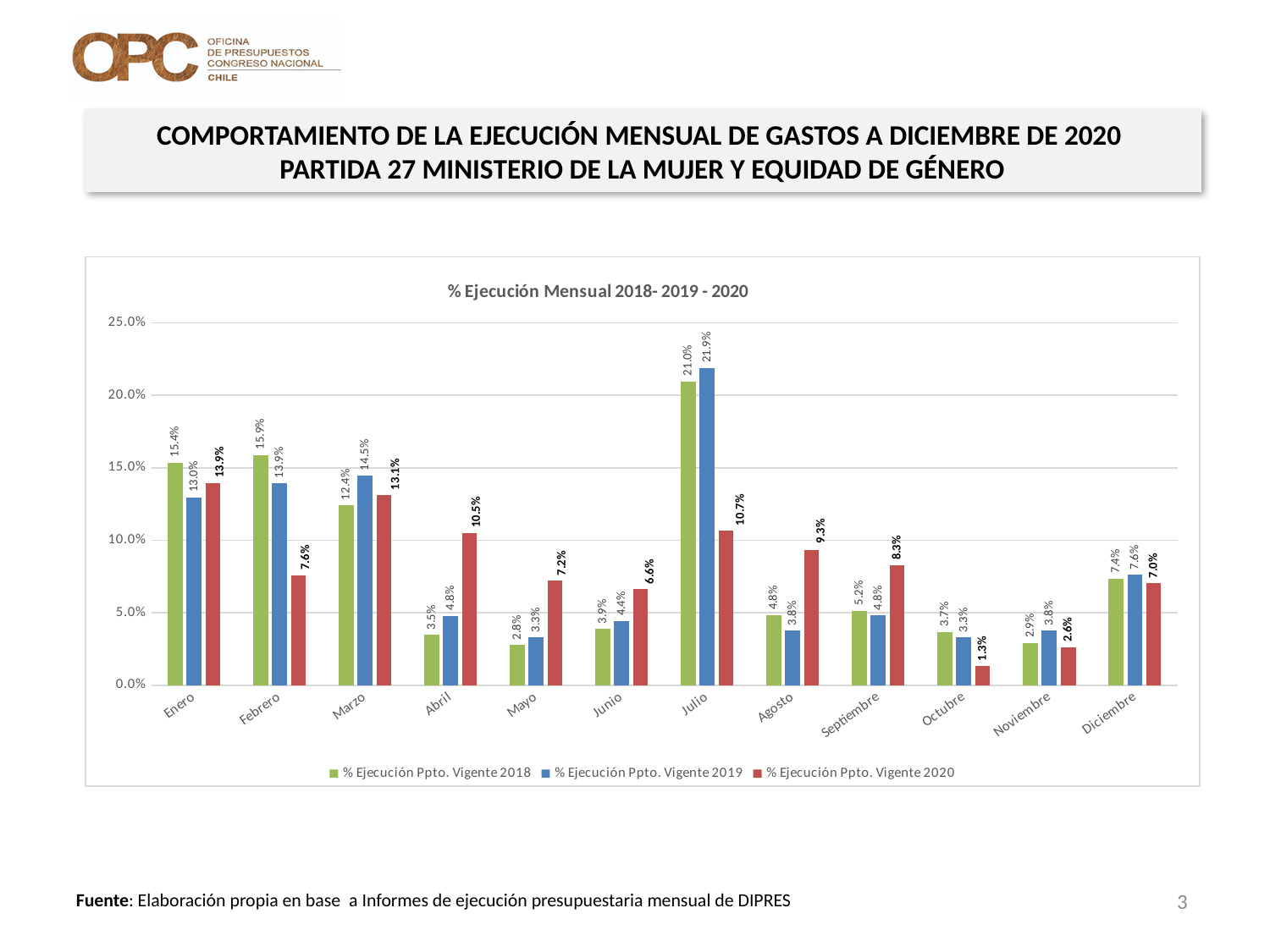
How many series does the legend list? 3 What kind of chart is shown on the slide? Bar chart Is the value for % Ejecución Ppto. Vigente 2018 in Enero greater or less than 15.0%? greater In Febrero, which is larger: the 2018 value or the 2020 value? 2018 What is the title of the chart? % Ejecución Mensual 2018- 2019 - 2020 What is the value for % Ejecución Ppto. Vigente 2019 in Marzo? 14.5% What is the value for % Ejecución Ppto. Vigente 2020 in Abril? 10.5% Which month has the highest value for % Ejecución Ppto. Vigente 2019? Julio What is the value for % Ejecución Ppto. Vigente 2018 in Julio? 21.0% Which month has the lowest value for % Ejecución Ppto. Vigente 2020? Octubre How many months are shown on the x axis? 12 What is the difference between the 2019 and 2020 values in Julio? 11.2%